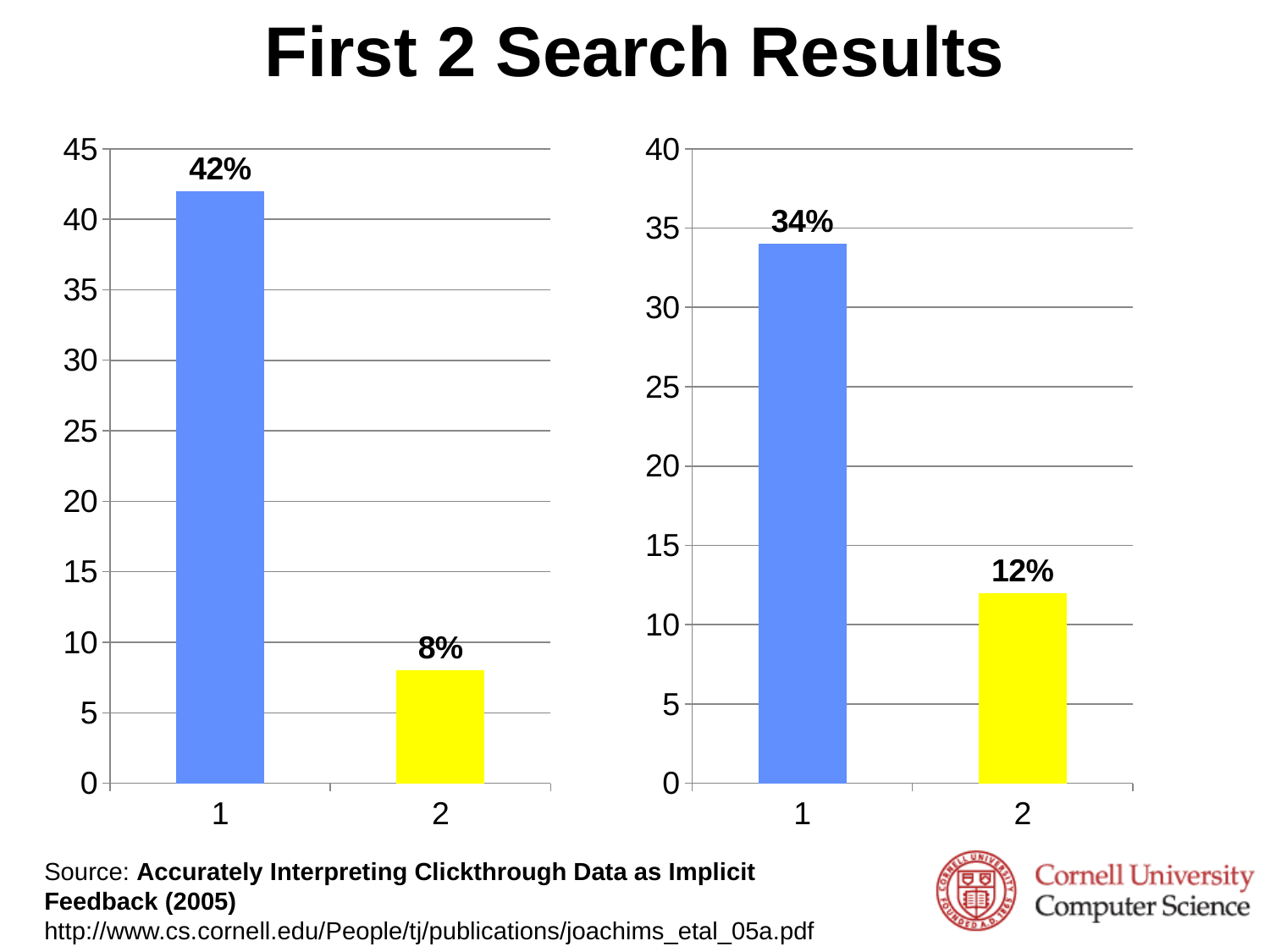
In the left chart, what is the difference between the values for category 1 and category 2? 34% In the right chart, what is the value for category 2? 12% In the left chart, which category has the highest value? 1 In the right chart, what is the value for category 1? 34% In the left chart, what is the value for category 1? 42% In the left chart, what is the value for category 2? 8% What kind of chart is the right chart? bar chart In the right chart, is the value for category 1 larger or smaller than the value for category 2? larger How many categories are shown in the left chart? 2 What is the title of the slide above the two charts? First 2 Search Results In the right chart, what is the difference between the values for category 1 and category 2? 22% In the right chart, which category has the lowest value? 2